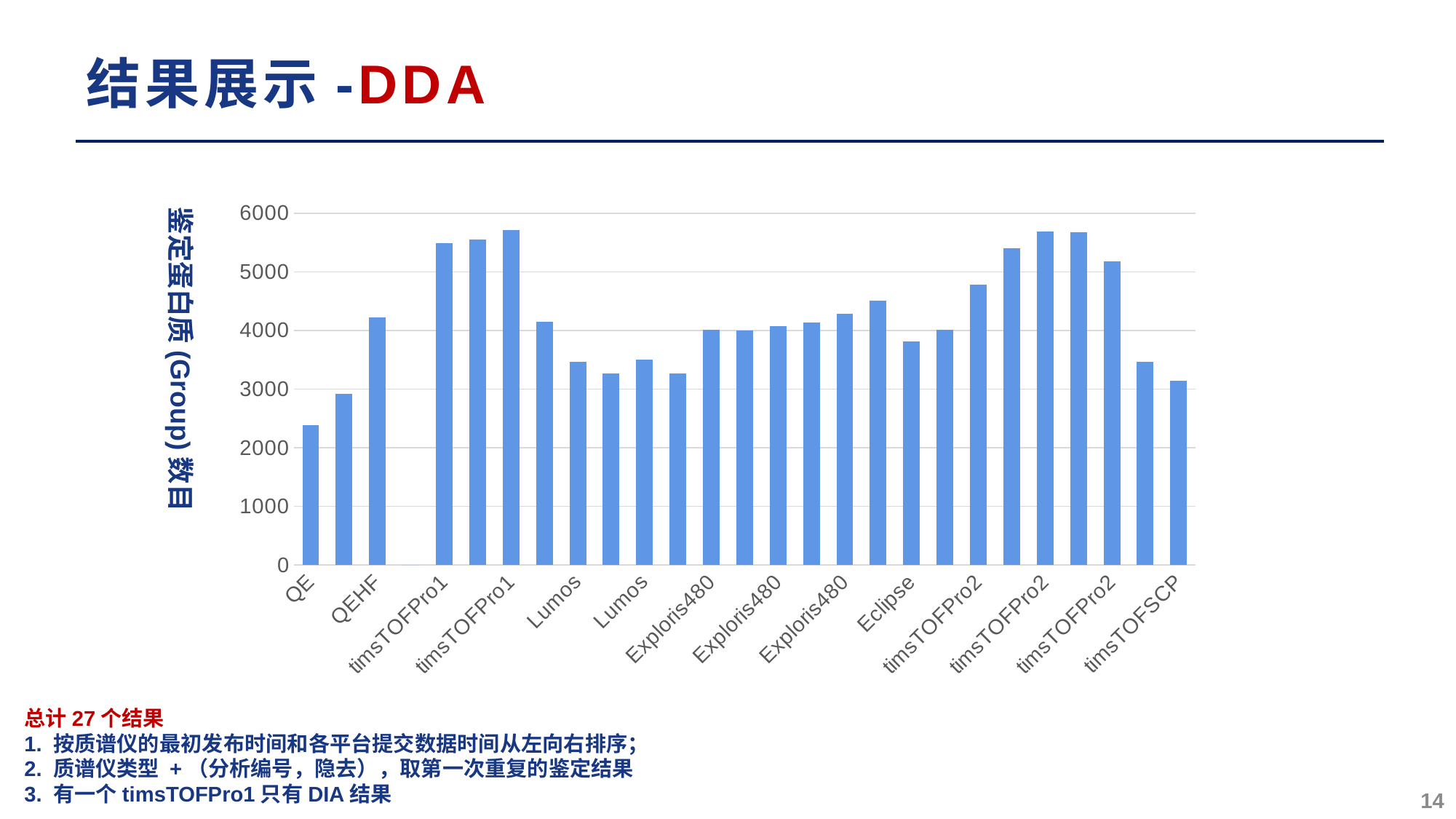
What is the title of the vertical axis? 鉴定蛋白质(Group)数目 Is the value for QE greater or less than 3000? less What kind of chart is shown on the slide? bar chart Is the value for QEHF greater or less than 2000? greater Is the value for QE greater or less than 2000? greater Which is larger, the value for QE or the value for QEHF? QEHF What is the highest tick value shown on the vertical axis? 6000 Which category has the lowest value in the chart? QE